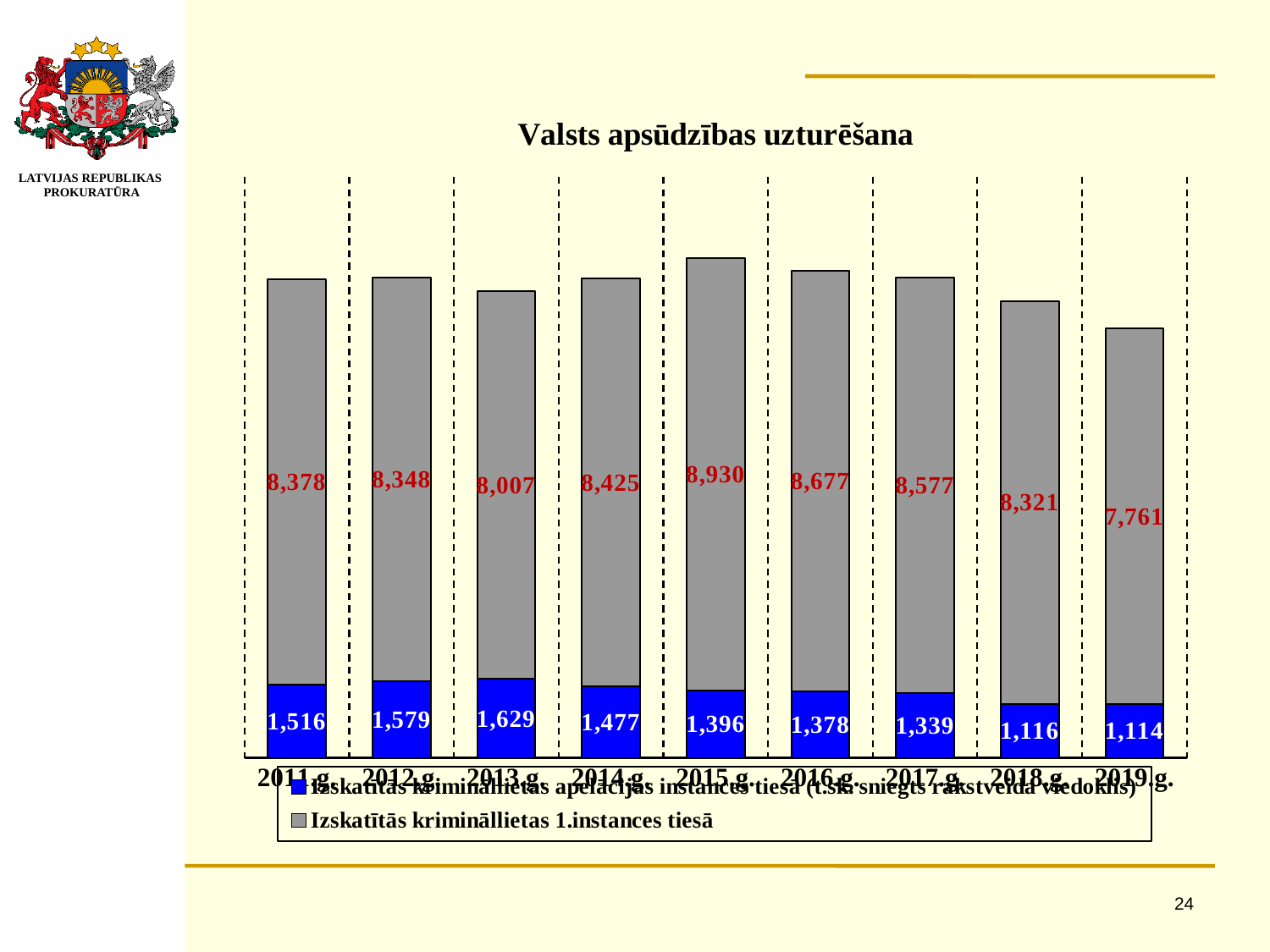
In which year is the value for Izskatītās krimināllietas apelācijas instances tiesā highest? 2013.g. In which year is the value for Izskatītās krimināllietas 1.instances tiesā lowest? 2019.g. What is the total of the stacked bar for 2015.g.? 10,326 What is the value for Izskatītās krimināllietas 1.instances tiesā in 2019.g.? 7,761 Which is larger, the 1.instances tiesā value for 2014.g. or for 2013.g.? 2014.g. What is the value for Izskatītās krimināllietas apelācijas instances tiesā in 2013.g.? 1,629 What kind of chart is shown on the slide? Stacked bar chart How many series does the legend list? 2 What is the difference between the 1.instances tiesā values for 2015.g. and 2019.g.? 1,169 In which year is the value for Izskatītās krimināllietas 1.instances tiesā highest? 2015.g. How many years are shown on the x axis? 9 What is the value for Izskatītās krimināllietas 1.instances tiesā in 2015.g.? 8,930